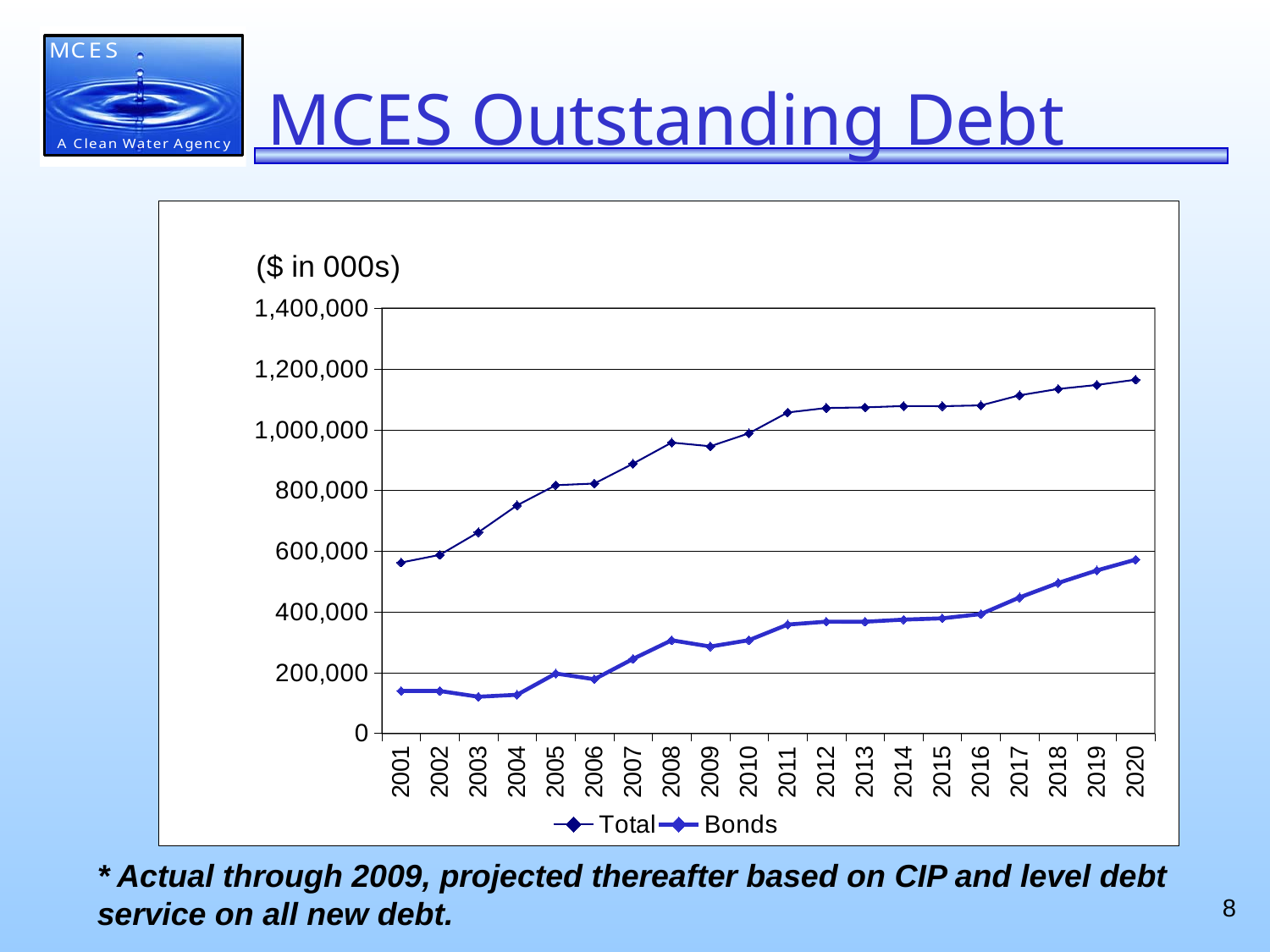
How many series does the legend list? 2 How many years are plotted along the x axis? 20 Which series is higher in 2015, Total or Bonds? Total In which year is the Total series at its lowest? 2001 Does the Total series generally rise or fall from 2001 to 2020? rise Is the Bonds value for 2011 greater or less than 400,000? less What unit note is printed above the chart's y axis? ($ in 000s) In which year is the Bonds series at its highest? 2020 Is the Total value for 2001 greater or less than 600,000? less In which year is the Total series at its highest? 2020 What kind of chart is shown on the slide? line chart Is the Total value for 2012 greater or less than 1,000,000? greater